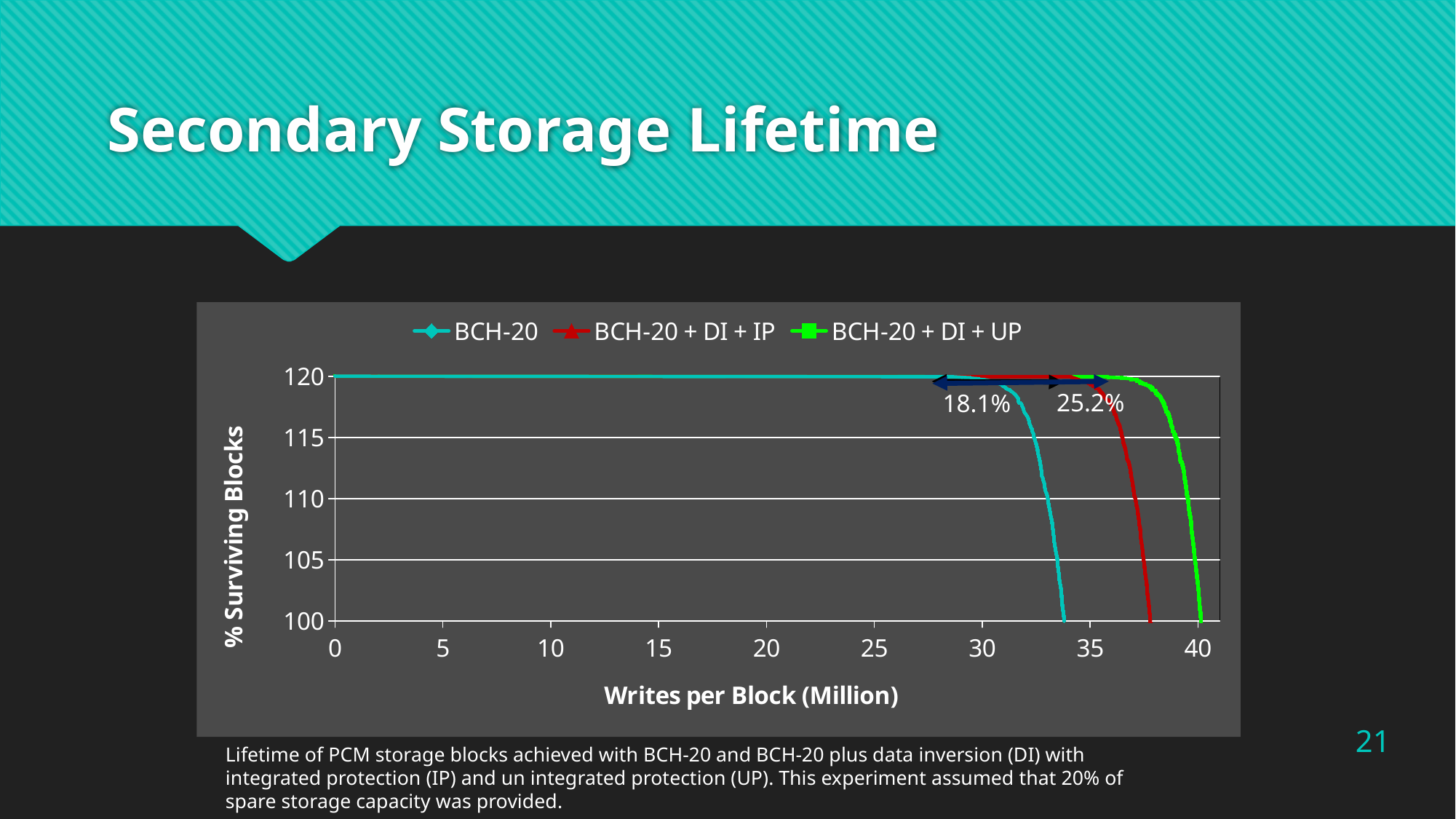
How many series does the legend list? 3 Do the % surviving blocks values rise or fall as writes per block increase past 30 million? fall Which series drops to 100% surviving blocks at the fewest writes per block? BCH-20 What is the title of the x axis? Writes per Block (Million) Does the BCH-20 + DI + IP series reach 100% surviving blocks at greater or less than 35 million writes per block? greater Which series survives to the highest number of writes per block before dropping to 100%? BCH-20 + DI + UP What kind of chart is shown on the slide? line chart What is the title of the y axis? % Surviving Blocks Does the BCH-20 series reach 100% surviving blocks at greater or less than 35 million writes per block? less What is the highest value shown on the y axis? 120 Which series reaches 100% surviving blocks at a larger number of writes per block, BCH-20 + DI + IP or BCH-20? BCH-20 + DI + IP How many tick labels are shown on the x axis? 9